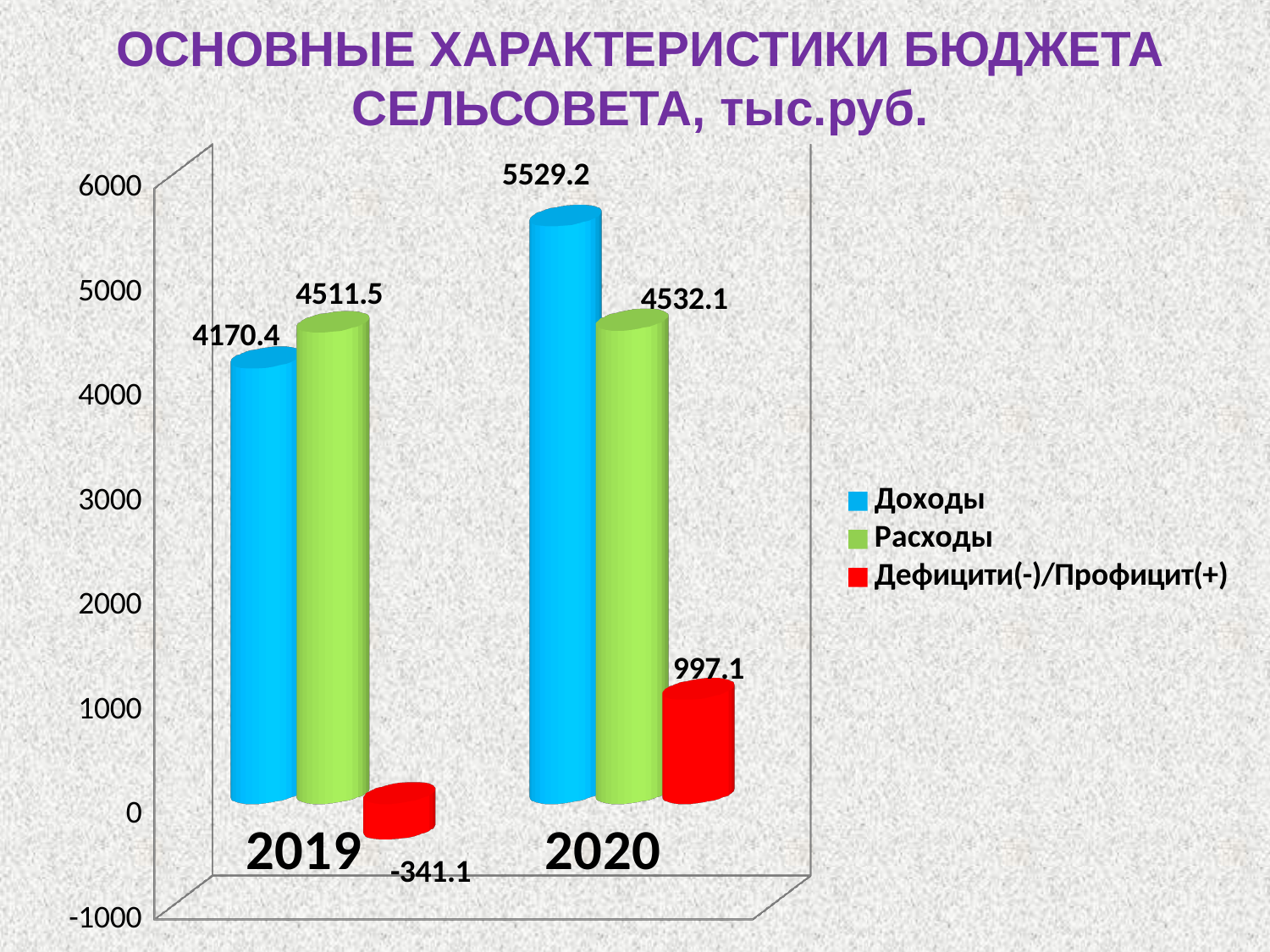
What is the value of Дефицити(-)/Профицит(+) for 2019? -341.1 What is the difference between Доходы and Расходы in 2020? 997.1 What is the value of Дефицити(-)/Профицит(+) for 2020? 997.1 In 2019, which is larger: Доходы or Расходы? Расходы Which series has the lowest value in 2019? Дефицити(-)/Профицит(+) What kind of chart is shown on the slide? Bar chart What is the value of Расходы for 2019? 4511.5 What is the value of Доходы for 2020? 5529.2 What is the difference between Доходы in 2020 and Доходы in 2019? 1358.8 How many series does the legend list? 3 Which year has the higher value for Доходы? 2020 Which colour represents Расходы in the chart? Green